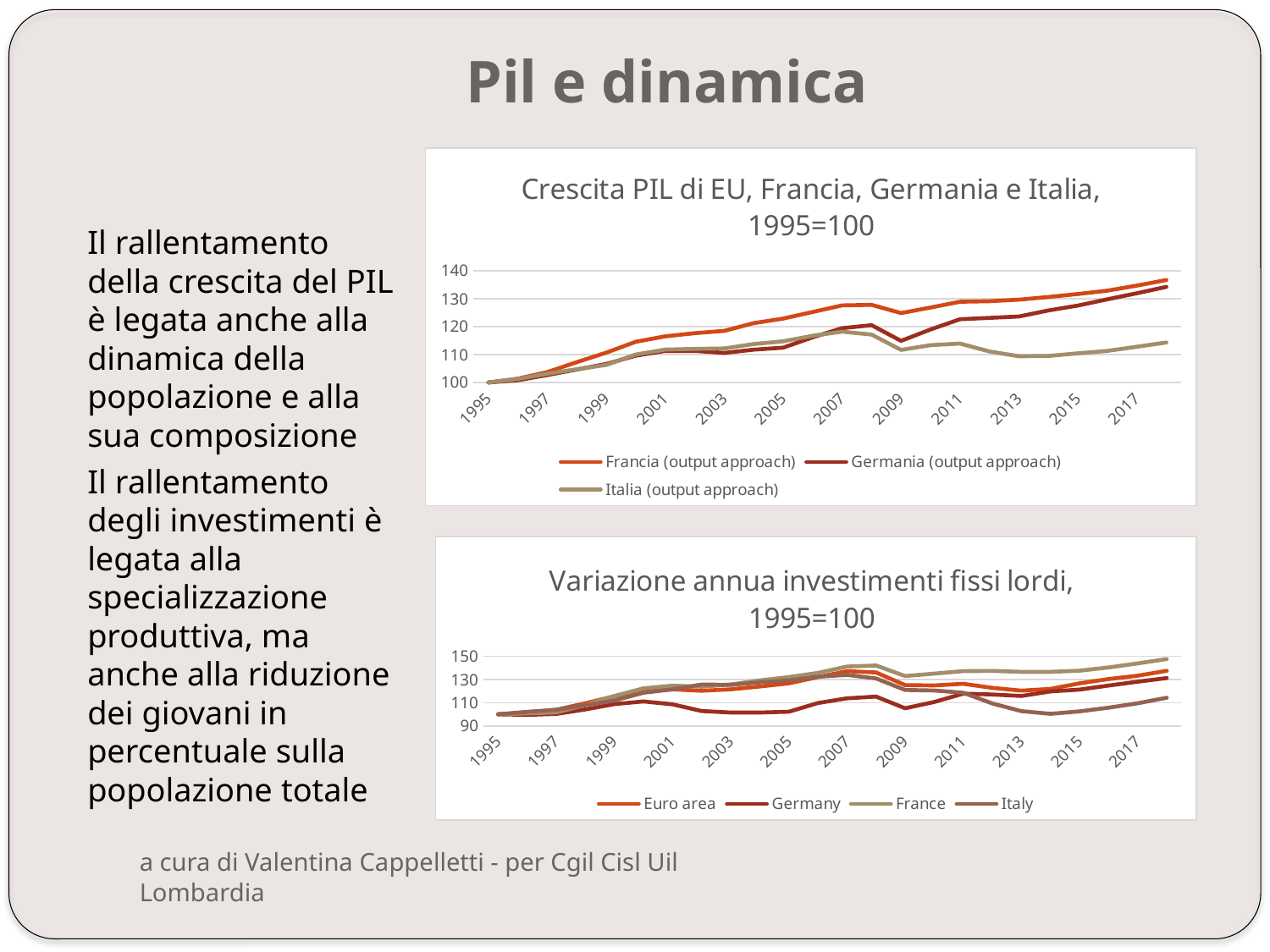
What kind of chart is the 'Crescita PIL di EU, Francia, Germania e Italia, 1995=100' chart? line chart In the 'Crescita PIL di EU, Francia, Germania e Italia, 1995=100' chart, does the Francia (output approach) line generally rise or fall from 1995 to 2017? rise In the 'Crescita PIL di EU, Francia, Germania e Italia, 1995=100' chart, what is the value for Italia (output approach) in 1995? 100 In the 'Variazione annua investimenti fissi lordi, 1995=100' chart, which is larger in 2017, France or Italy? France How many series does the legend of the 'Crescita PIL di EU, Francia, Germania e Italia, 1995=100' chart list? 3 In the 'Variazione annua investimenti fissi lordi, 1995=100' chart, which series is lowest in 2017? Italy In the 'Crescita PIL di EU, Francia, Germania e Italia, 1995=100' chart, is the value for Italia (output approach) in 2017 greater or less than 120? less In the 'Variazione annua investimenti fissi lordi, 1995=100' chart, which series is highest in 2017? France In the 'Crescita PIL di EU, Francia, Germania e Italia, 1995=100' chart, is the value for Francia (output approach) in 2017 greater or less than 130? greater In the 'Crescita PIL di EU, Francia, Germania e Italia, 1995=100' chart, which series is lowest in 2017? Italia (output approach) How many series does the legend of the 'Variazione annua investimenti fissi lordi, 1995=100' chart list? 4 In the 'Variazione annua investimenti fissi lordi, 1995=100' chart, is the value for Italy in 2017 greater or less than 130? less